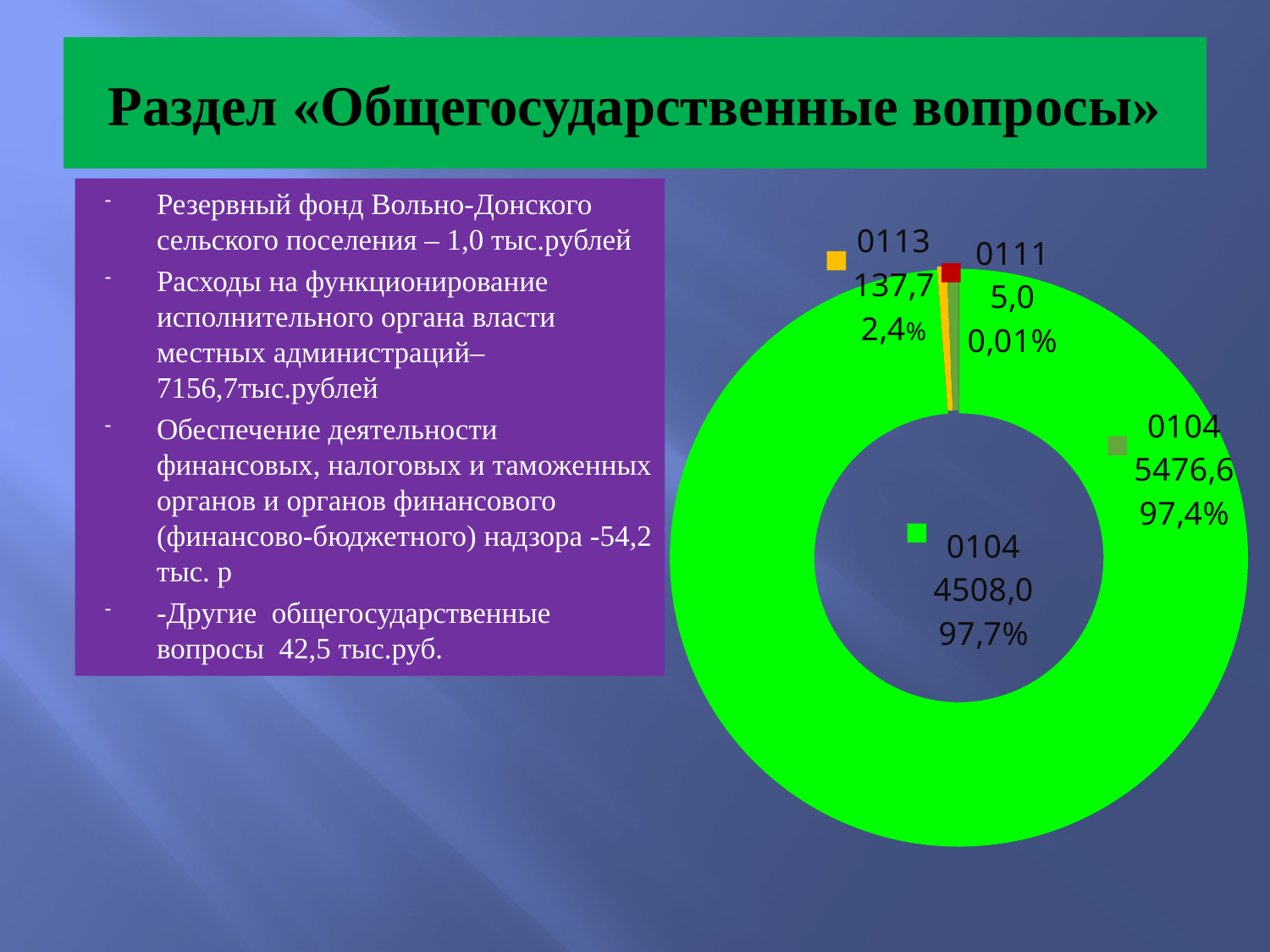
What value is printed for the slice labelled 0113? 137,7 What is the difference between the value for 0113 (137,7) and the value for 0111 (5,0)? 132,7 What percentage is printed for the slice labelled 0113? 2,4% What percentage is printed on the largest (bright green) slice of the chart? 97,7% Which labelled slice has the smallest percentage printed on the chart? 0111 Which is larger, the value for 0113 or the value for 0111? 0113 What kind of chart is shown on the slide? doughnut chart What percentage is printed for the slice labelled 0111? 0,01% What value is printed on the largest (bright green) slice of the chart? 4508,0 What colour is the slice labelled 0113? yellow What value is printed for the slice labelled 0111? 5,0 What colour is the slice labelled 0111? red